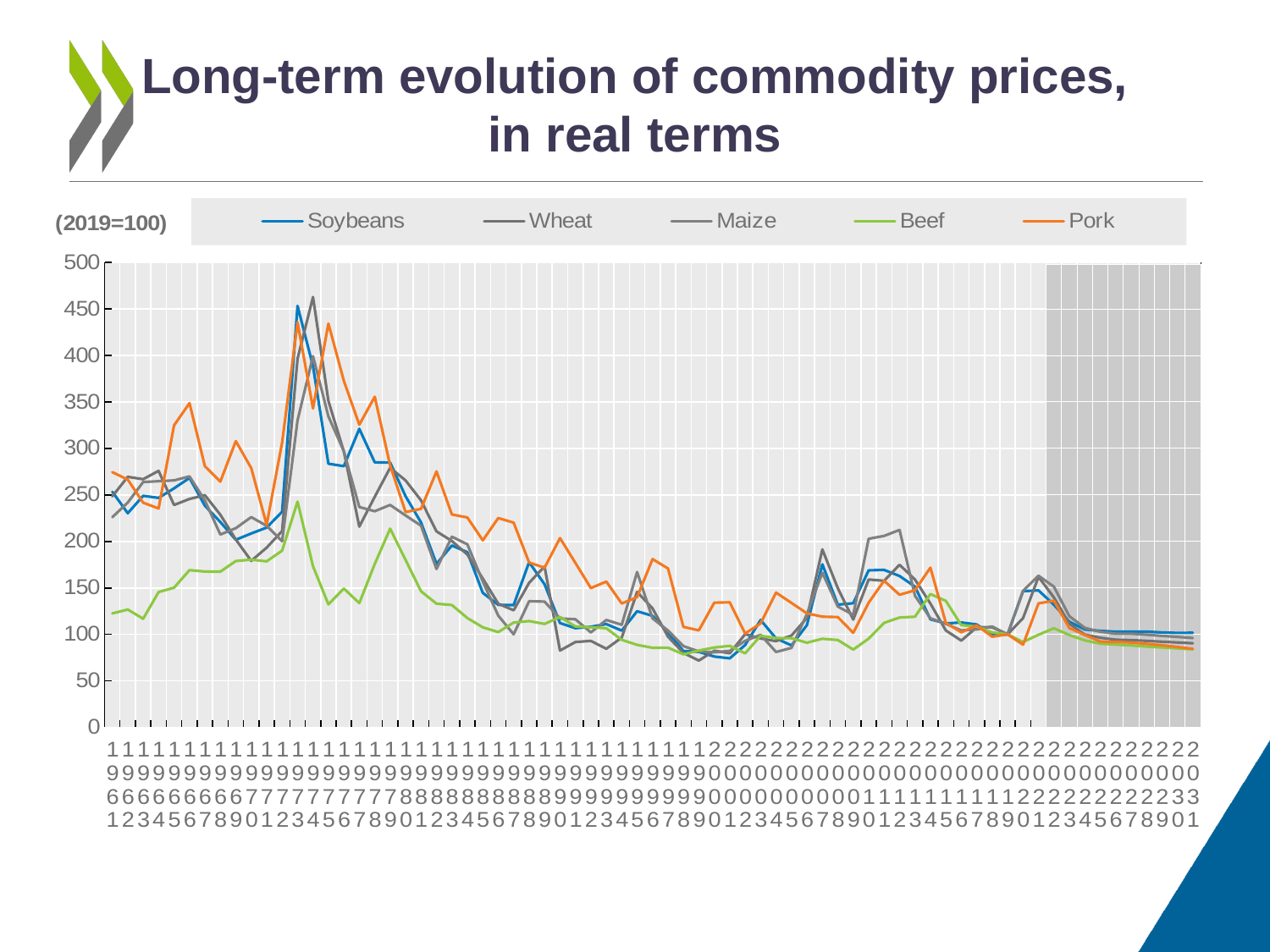
Is the peak value for Beef in the mid-1970s greater or less than 200? greater In 1961, which is higher, Beef or Pork? Pork Is the peak value for Soybeans in the early 1970s greater or less than 400? greater Which year is used as the base year (index = 100) for the chart? 2019 How many series does the legend list? 5 Do the commodity price indices generally rise or fall from the mid-1970s to the 2000s? fall Is the peak value for Pork in the mid-1970s greater or less than 400? greater What kind of chart is shown on the slide? line chart Which series is the lowest throughout the 1960s? Beef What is the title of the chart? Long-term evolution of commodity prices, in real terms